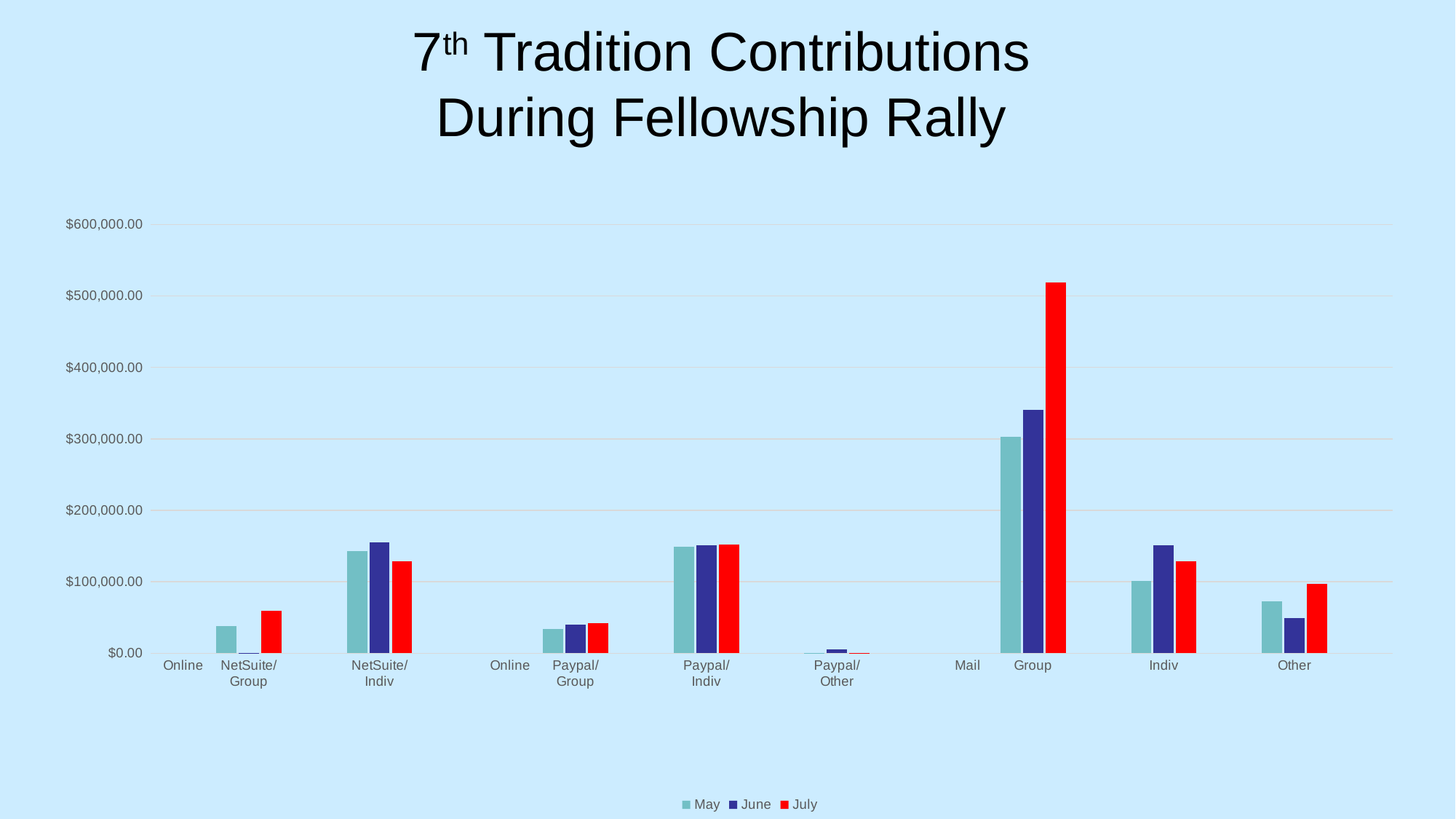
How many series does the legend list? 3 Which category has the tallest bar in the chart? Group Is the July value for Group greater or less than $500,000.00? greater Which series has the highest value for the Group category? July Is the June value for NetSuite/Indiv greater or less than $100,000.00? greater For the Indiv category, which is larger: the May value or the June value? June What is the title of the chart? 7th Tradition Contributions During Fellowship Rally Is the May value for Paypal/Group greater or less than $100,000.00? less What kind of chart is shown on the slide? bar chart Do the values for the Group category rise or fall from May to July? rise Which series are listed in the legend? May, June, July